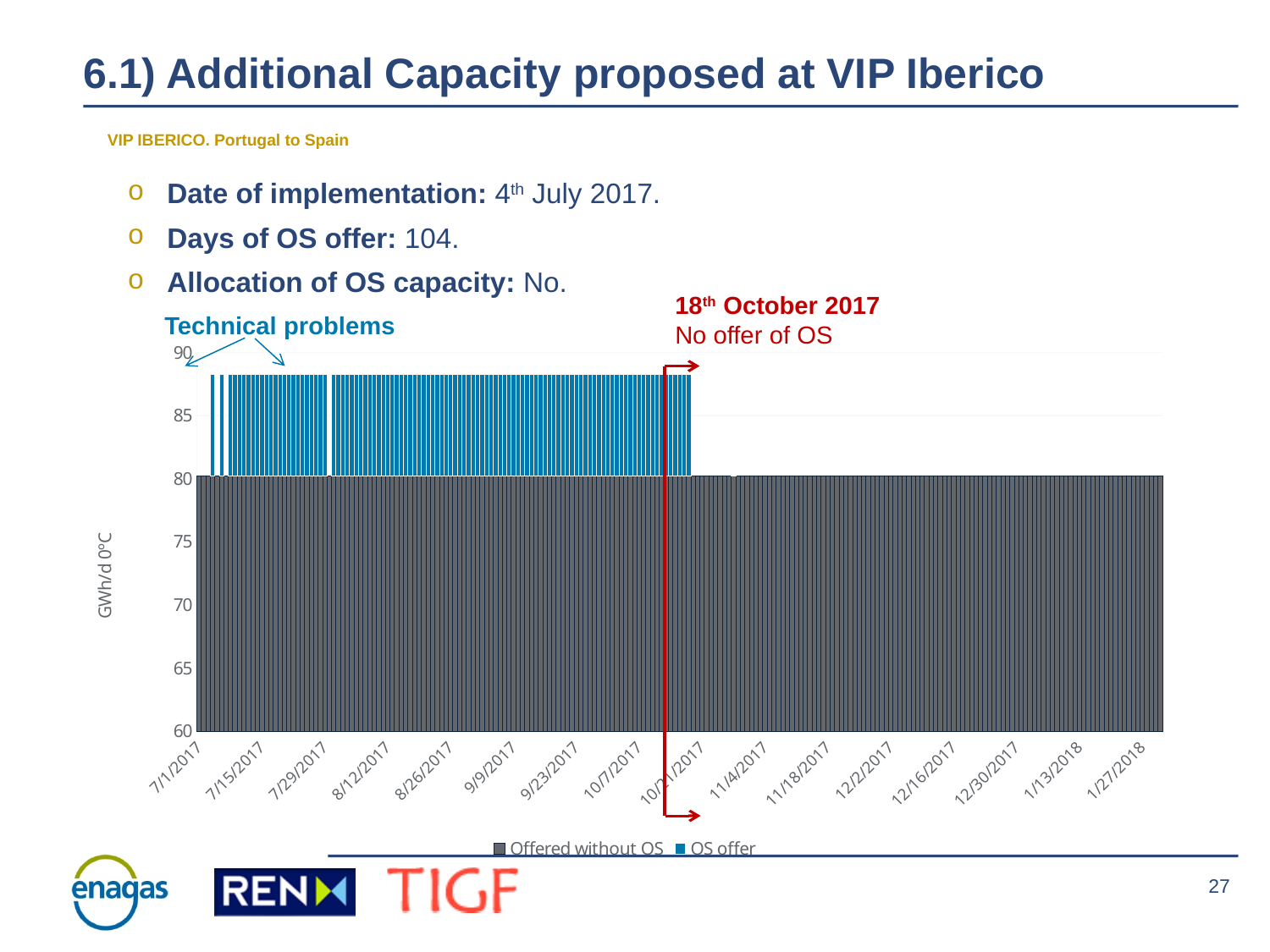
Does the total offered capacity rise or fall after mid-October 2017? fall Which date has the larger total offered capacity, 8/12/2017 or 11/4/2017? 8/12/2017 What kind of chart is shown on the slide? bar chart How many date labels are shown along the x axis? 16 Is the total offered capacity on 11/18/2017 greater or less than 85? less Is the value of Offered without OS on 7/15/2017 greater or less than 85? less What is the label on the chart's vertical axis? GWh/d 0°C What are the two series named in the chart legend? Offered without OS; OS offer Is the value of Offered without OS on 12/2/2017 greater or less than 75? greater How many series does the chart legend list? 2